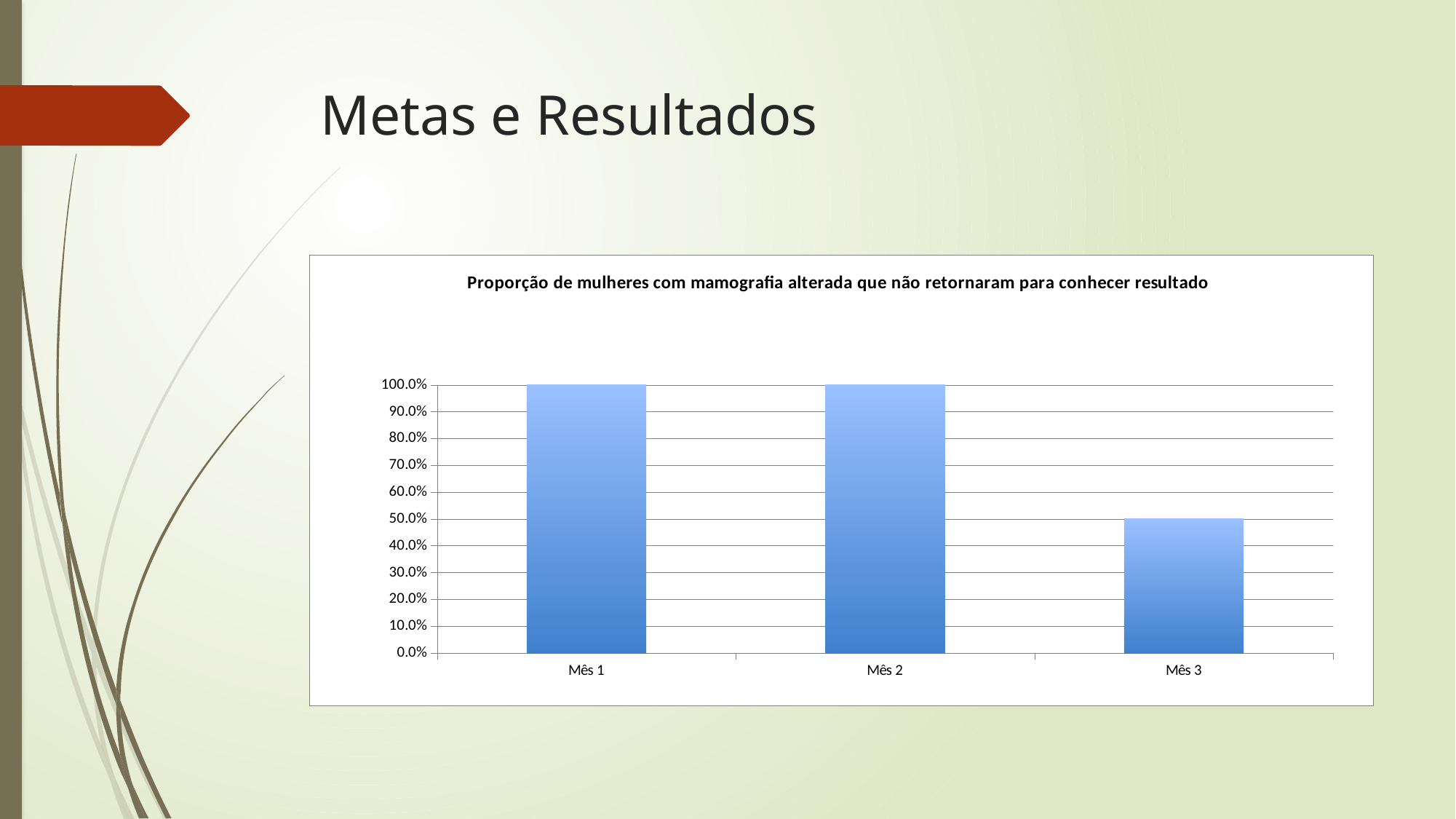
What is the value for Mês 3? 50.0% What is the value for Mês 1? 100.0% What kind of chart is shown on the slide? bar chart Do the values rise or fall from Mês 2 to Mês 3? fall What is the value for Mês 2? 100.0% How many categories are plotted on the x axis of the chart? 3 Which category has the lowest value? Mês 3 What is the title of the chart? Proporção de mulheres com mamografia alterada que não retornaram para conhecer resultado Which is larger, the value for Mês 2 or the value for Mês 3? Mês 2 Is the value for Mês 3 greater or less than 60.0%? less What is the difference between the value for Mês 1 and the value for Mês 3? 50.0% Is the value for Mês 1 greater or less than 90.0%? greater